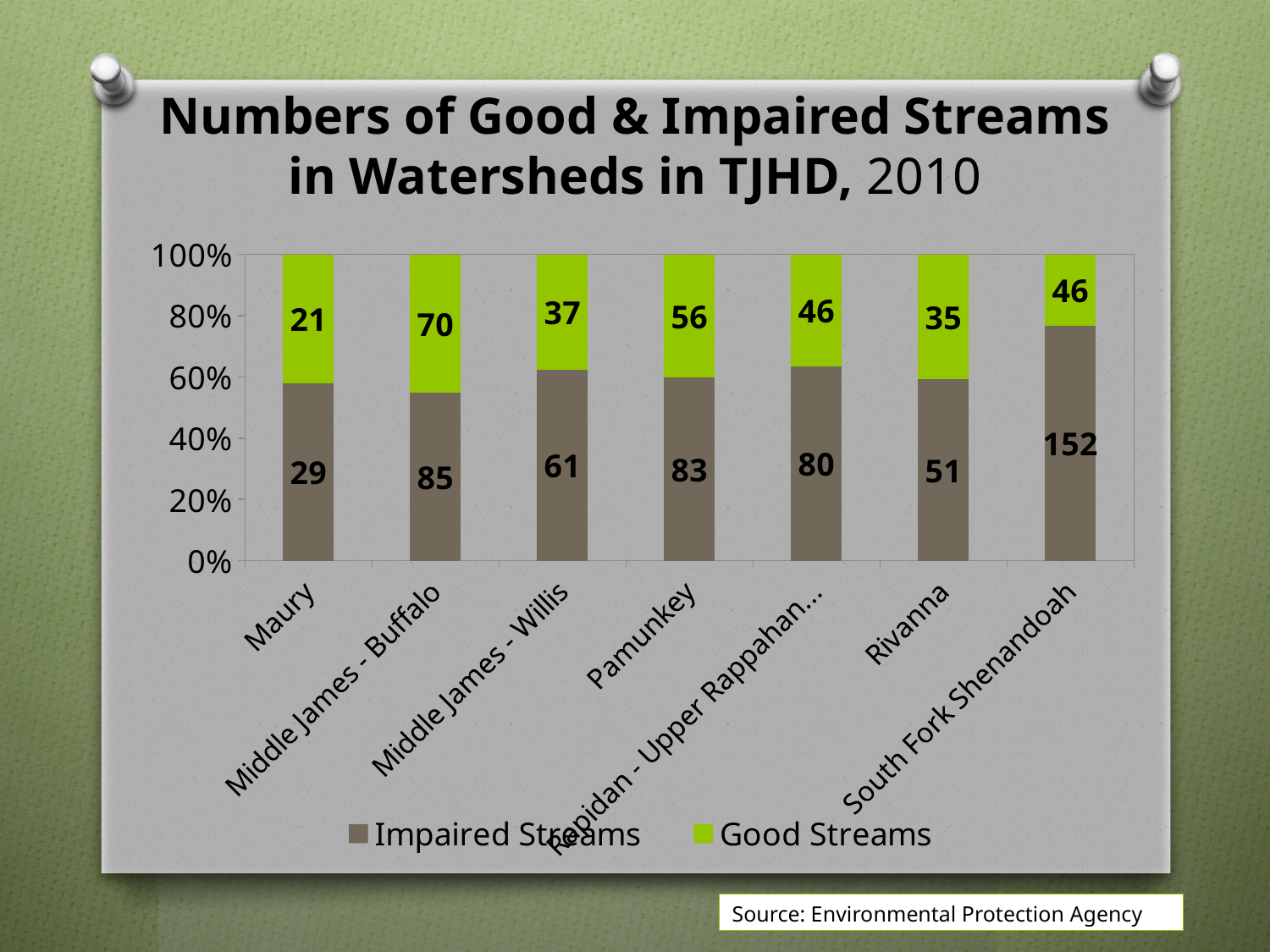
How many good streams are shown for Rivanna? 35 Which has more good streams, Middle James - Willis or Pamunkey? Pamunkey How many watersheds are shown on the x axis? 7 What kind of chart is shown on the slide? Stacked bar chart How many impaired streams are shown for Maury? 29 How many good streams are shown for Middle James - Buffalo? 70 Which watershed has the lowest number of good streams? Maury What is the total number of streams (impaired plus good) for Middle James - Buffalo? 155 What is the difference between the number of impaired streams and good streams in Pamunkey? 27 How many series does the legend list? 2 Which watershed has the highest number of impaired streams? South Fork Shenandoah How many impaired streams are shown for South Fork Shenandoah? 152